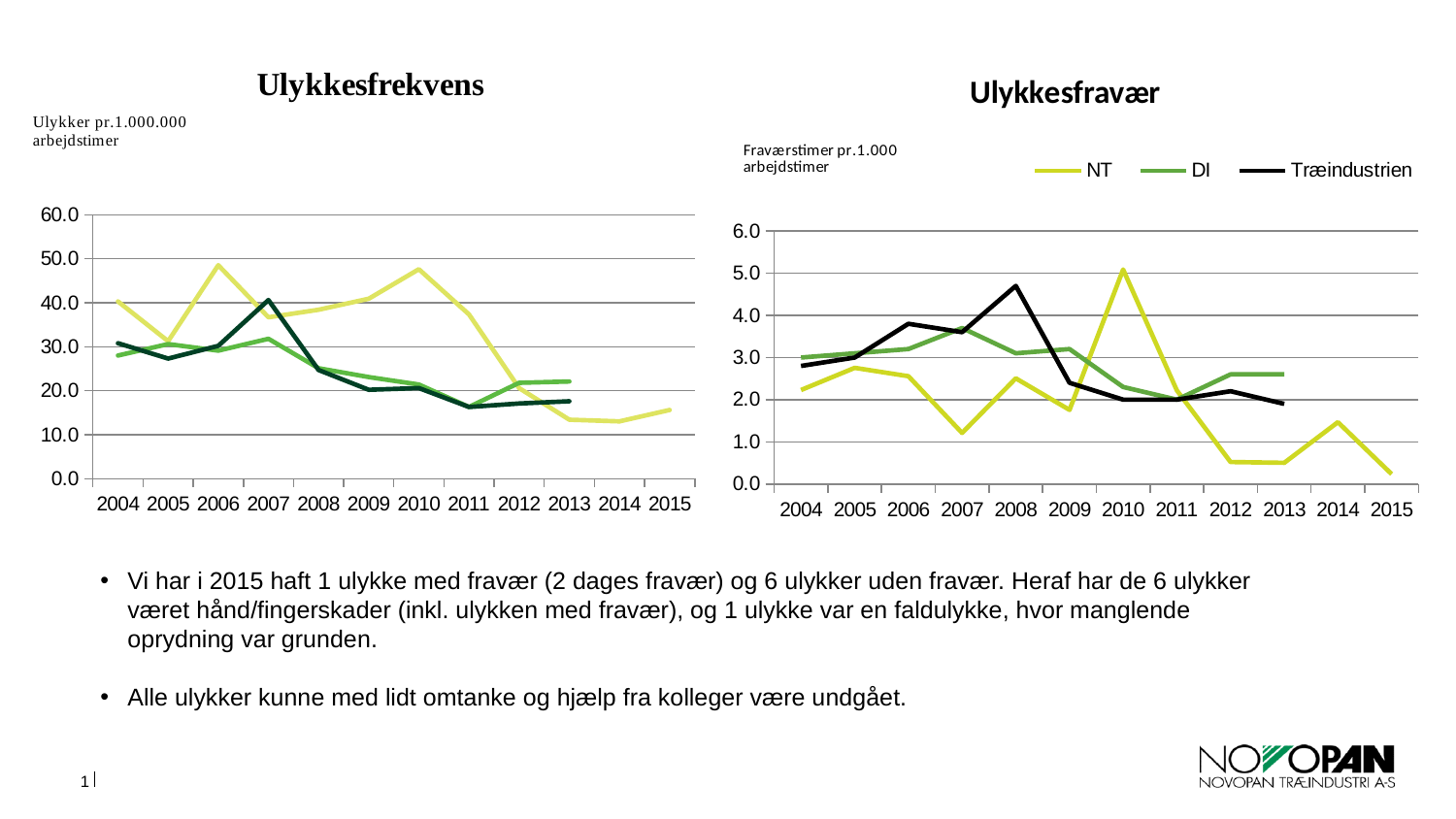
In the Ulykkesfravær chart, is the value for Træindustrien in 2008 greater or less than 4.0? greater In the Ulykkesfravær chart, which is larger in 2008: NT or Træindustrien? Træindustrien How many series does the legend of the Ulykkesfravær chart list? 3 In the Ulykkesfrekvens chart, is the value of the yellow line in 2014 greater or less than 20.0? less In the Ulykkesfravær chart, which year has the highest value for NT? 2010 In the Ulykkesfravær chart, is the value for NT in 2015 greater or less than 1.0? less How many years are shown on the x axis of the Ulykkesfrekvens chart? 12 In the Ulykkesfravær chart, does the NT line rise or fall from 2010 to 2012? fall What kind of chart is the Ulykkesfravær chart on the right? line chart What is the title of the chart on the left of the slide? Ulykkesfrekvens In the Ulykkesfravær chart, which year has the highest value for Træindustrien? 2008